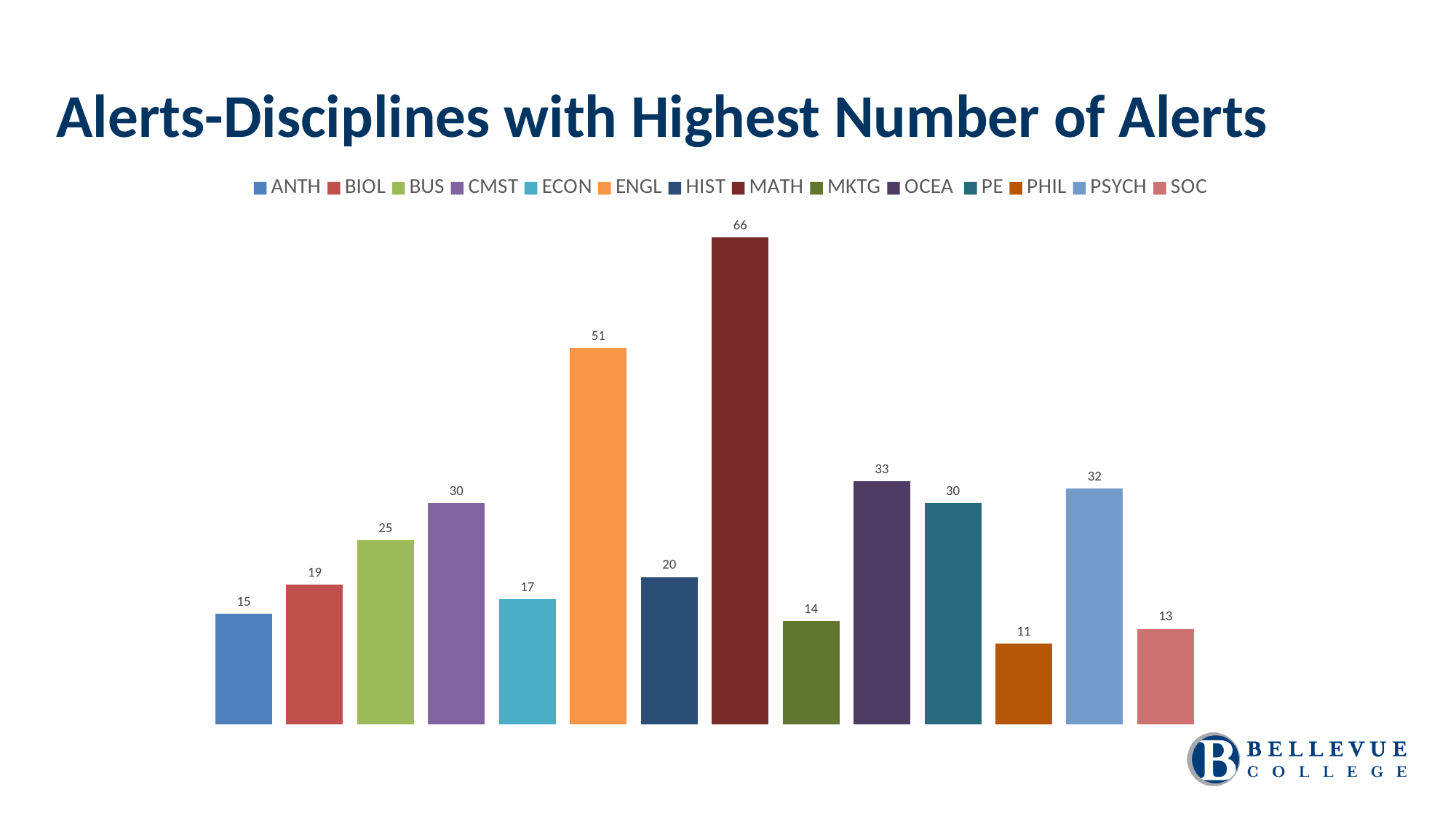
Which discipline has the highest number of alerts? MATH What is the difference in alerts between MATH and ENGL? 15 Which has more alerts, PE or SOC? PE What is the number of alerts for ENGL? 51 Which discipline has the lowest number of alerts? PHIL What is the difference in alerts between OCEA and MKTG? 19 What is the number of alerts for PSYCH? 32 How many disciplines are shown in the chart? 14 What kind of chart is shown on the slide? Bar chart Which has more alerts, BUS or HIST? BUS What is the number of alerts for MATH? 66 What is the title of the chart? Alerts-Disciplines with Highest Number of Alerts